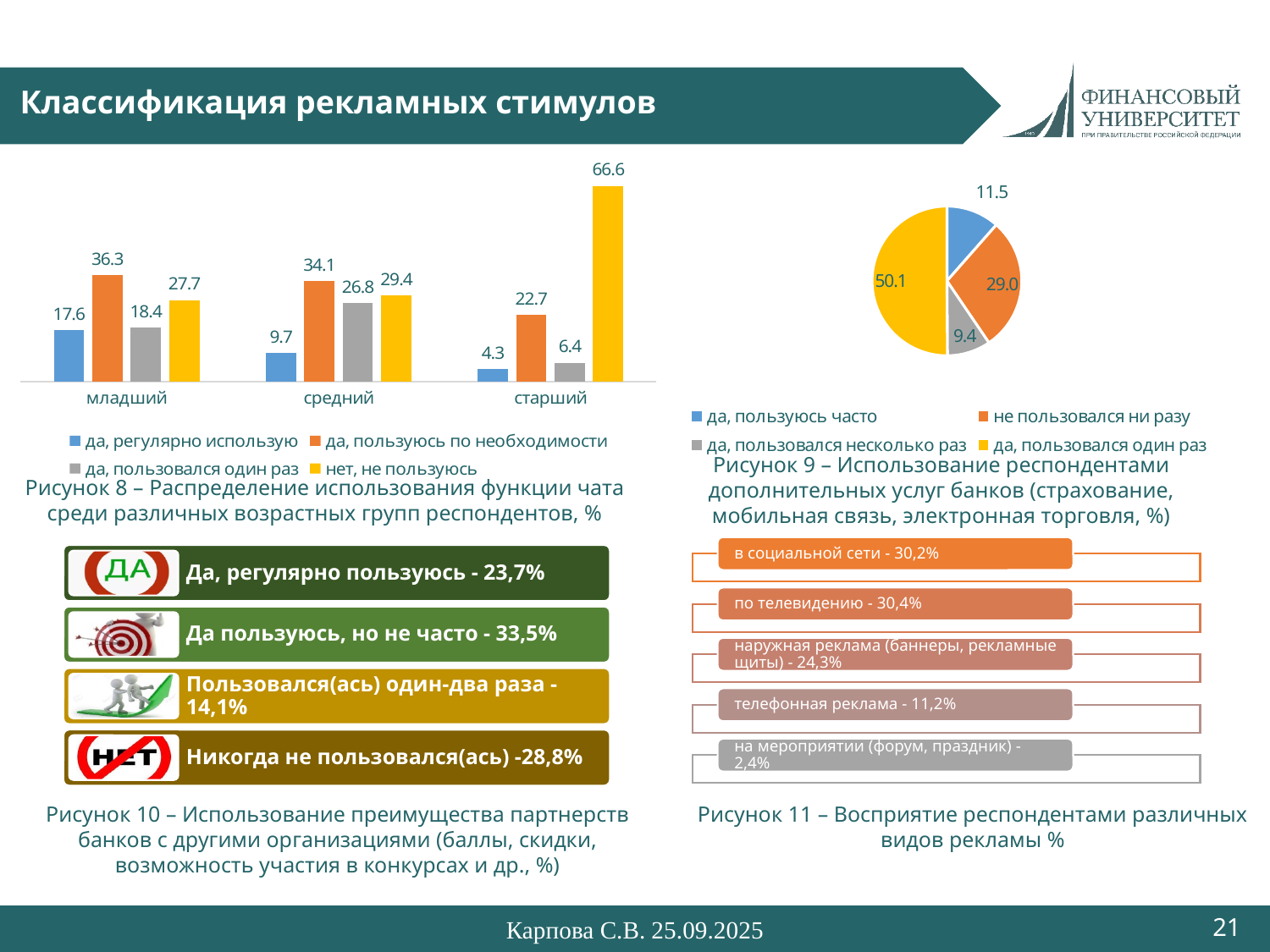
In the bar chart (Рисунок 8), what is the difference between 'нет, не пользуюсь' for 'старший' and for 'младший'? 38.9 In the pie chart (Рисунок 9), which category has the smallest slice? да, пользовался несколько раз In the pie chart (Рисунок 9), what is the value for 'да, пользовался один раз'? 50.1 In the bar chart (Рисунок 8), which age group has the lowest value for 'да, регулярно использую'? старший In the pie chart (Рисунок 9), which is larger: 'не пользовался ни разу' or 'да, пользуюсь часто'? не пользовался ни разу In the bar chart (Рисунок 8), what is the value for 'да, пользовался один раз' in the 'средний' group? 26.8 In the bar chart (Рисунок 8), what is the value for 'да, регулярно использую' in the 'младший' group? 17.6 In the bar chart (Рисунок 8), which age group has the highest value for 'да, пользуюсь по необходимости'? младший In the bar chart (Рисунок 8), how many series does the legend list? 4 What kind of chart is Рисунок 9? pie chart In the bar chart (Рисунок 8), does the value for 'да, регулярно использую' rise or fall from 'младший' to 'старший'? fall In the bar chart (Рисунок 8), what is the value for 'нет, не пользуюсь' in the 'старший' group? 66.6